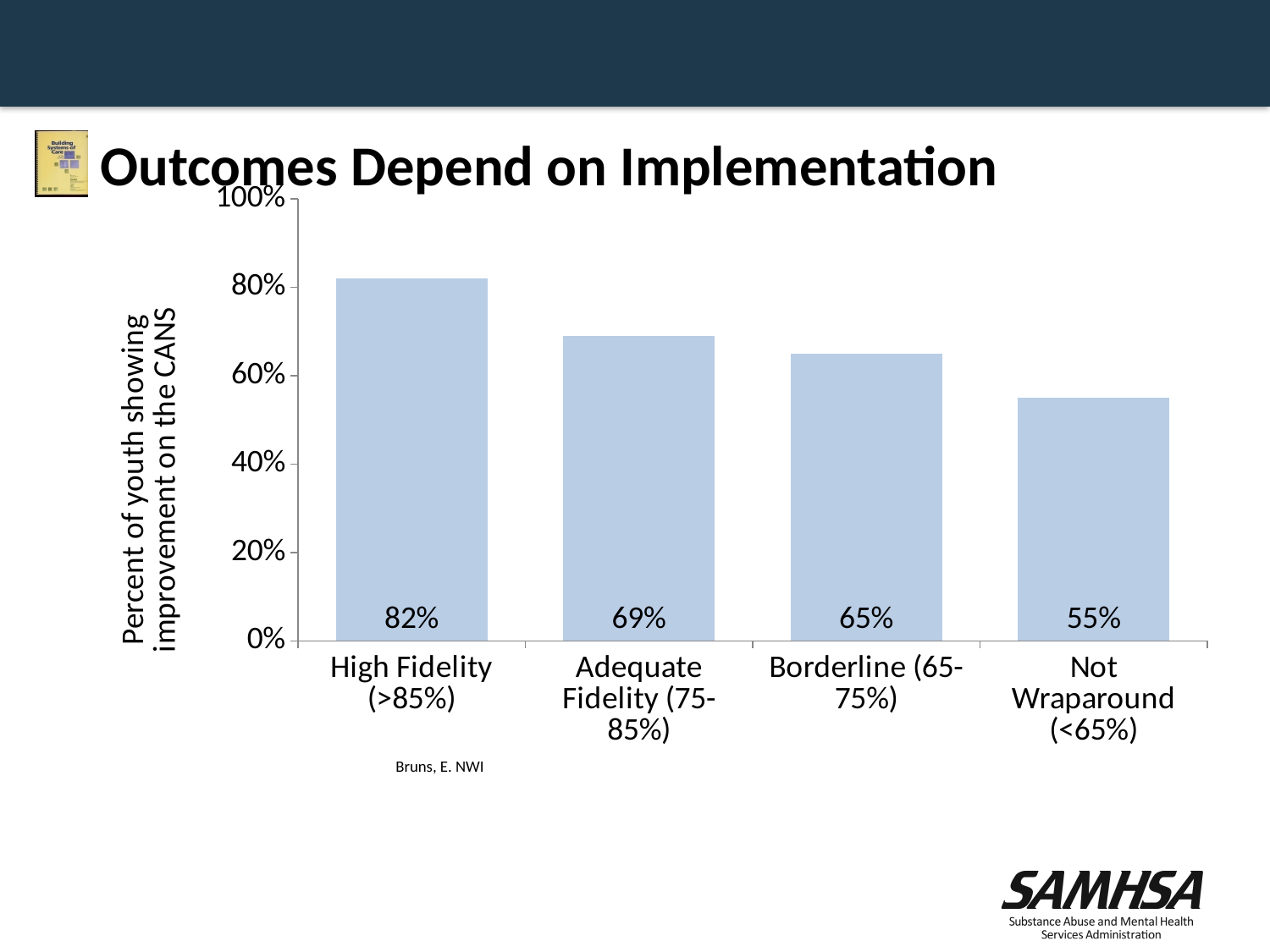
Which category has the highest percent of youth showing improvement? High Fidelity (>85%) What is the difference in percentage points between High Fidelity (>85%) and Not Wraparound (<65%)? 27 Which category has the lowest percent of youth showing improvement? Not Wraparound (<65%) What is the value for Borderline (65-75%)? 65% Do the values rise or fall moving from left to right across the categories? Fall How many categories are shown on the chart? 4 What kind of chart is shown on the slide? Bar chart Which is larger, the value for Adequate Fidelity (75-85%) or Borderline (65-75%)? Adequate Fidelity (75-85%) What percent of youth showed improvement on the CANS for High Fidelity (>85%)? 82% What is the value for Adequate Fidelity (75-85%)? 69% Is the value for Borderline (65-75%) greater or less than 60%? greater What is the value for Not Wraparound (<65%)? 55%